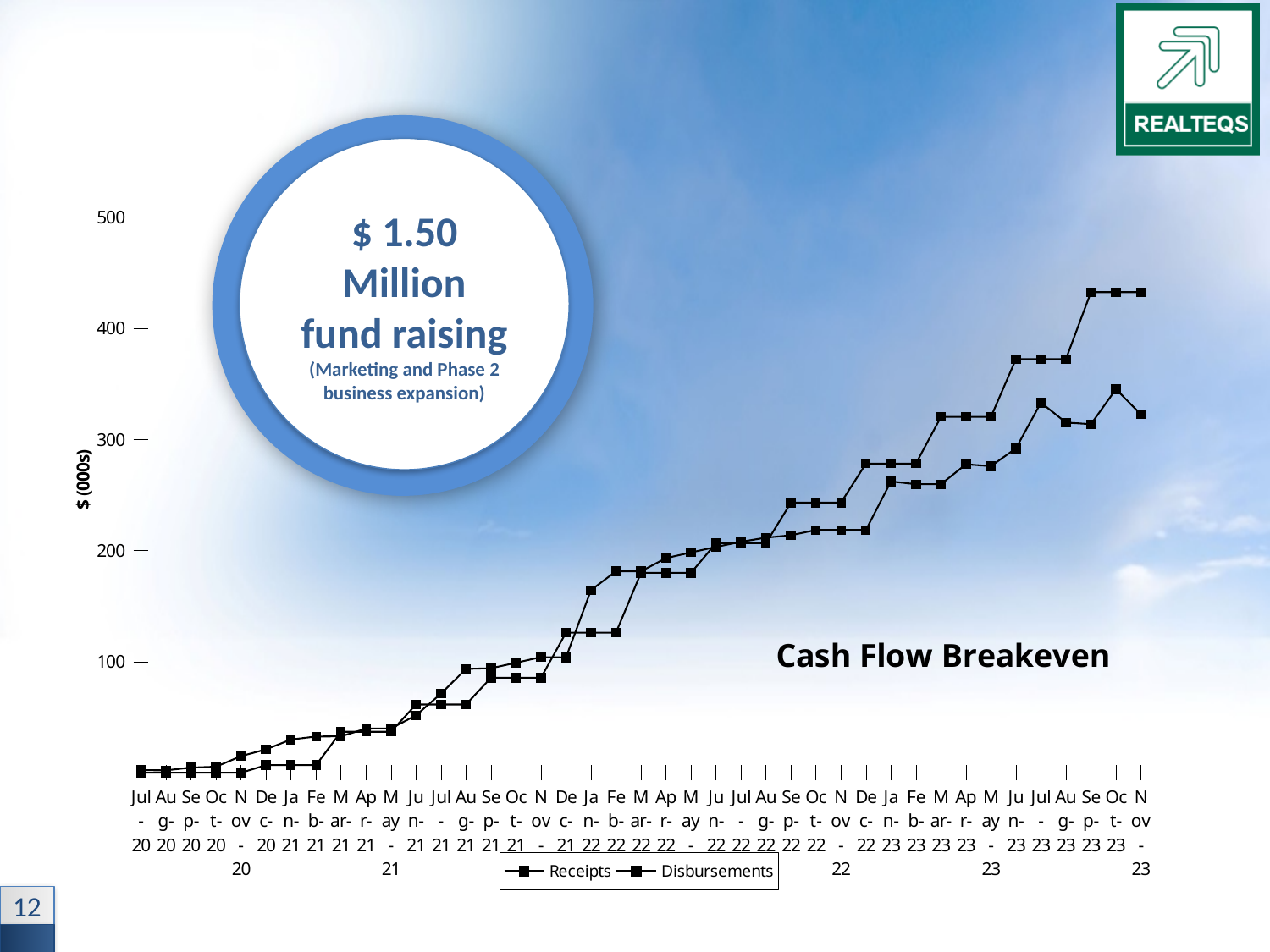
What is the first month shown on the chart's horizontal axis? Jul-20 What is the label on the chart's vertical axis? $ (000s) Is the value for Nov-23 greater or less than 300 for both series? greater How many series does the chart's legend list? 2 What is the highest tick value shown on the chart's vertical axis? 500 Is the value for Dec-21 greater or less than 200 for both series? less Is the value for Jan-23 greater or less than 200 for both series? greater Do the plotted values generally rise or fall from Jul-20 to Nov-23? Rise What kind of chart is shown on the slide? Line chart What are the two series named in the chart's legend? Receipts and Disbursements